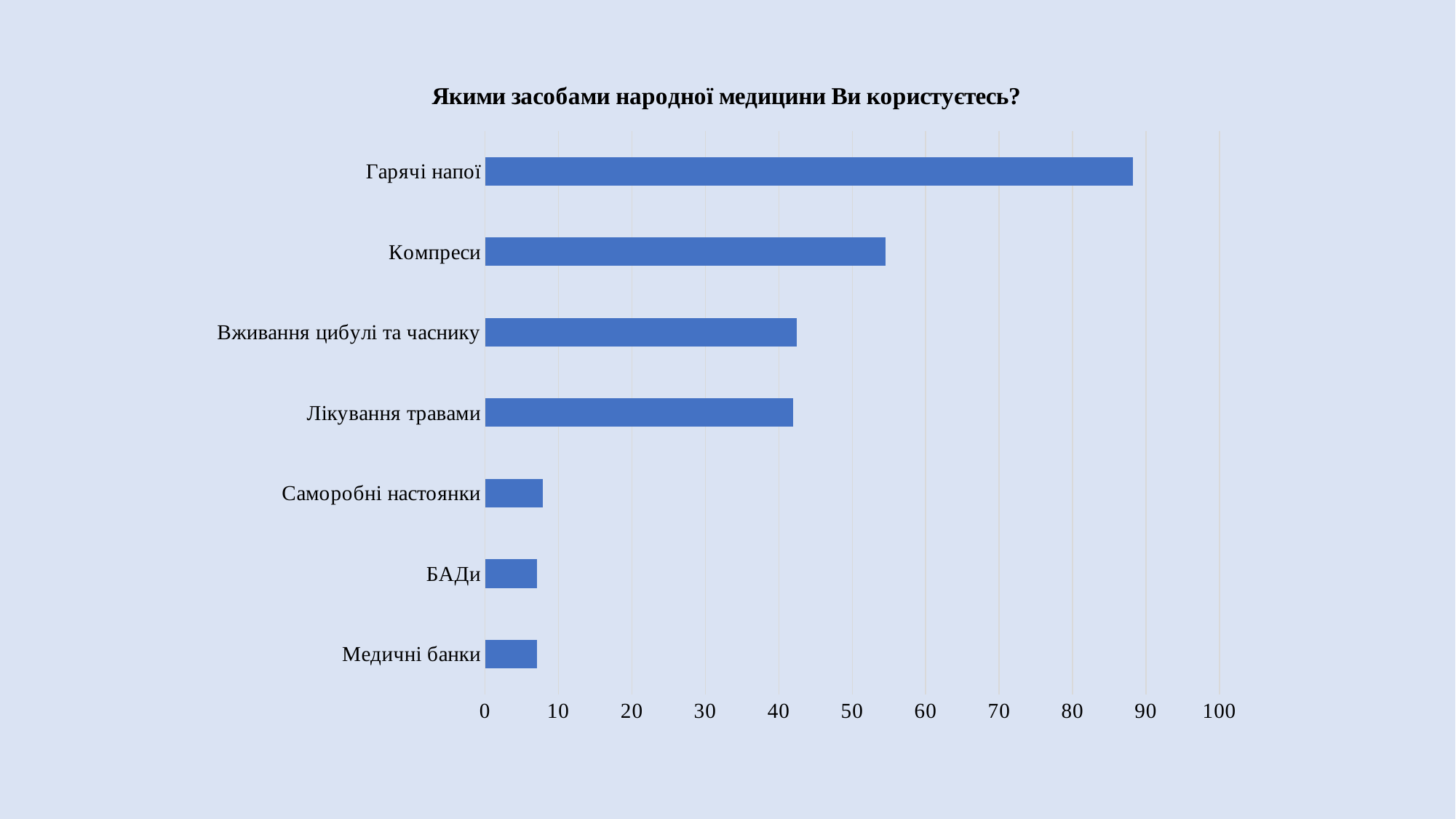
Which category has the highest value? Гарячі напої Is the value for Медичні банки greater or less than 10? less What kind of chart is shown on the slide? bar chart Is the value for Лікування травами greater or less than 30? greater Is the value for Вживання цибулі та часнику greater or less than 50? less What is the title of the chart? Якими засобами народної медицини Ви користуєтесь? Which is larger, the value for БАДи or the value for Вживання цибулі та часнику? Вживання цибулі та часнику Which is larger, the value for Компреси or the value for Лікування травами? Компреси How many categories are shown in the chart? 7